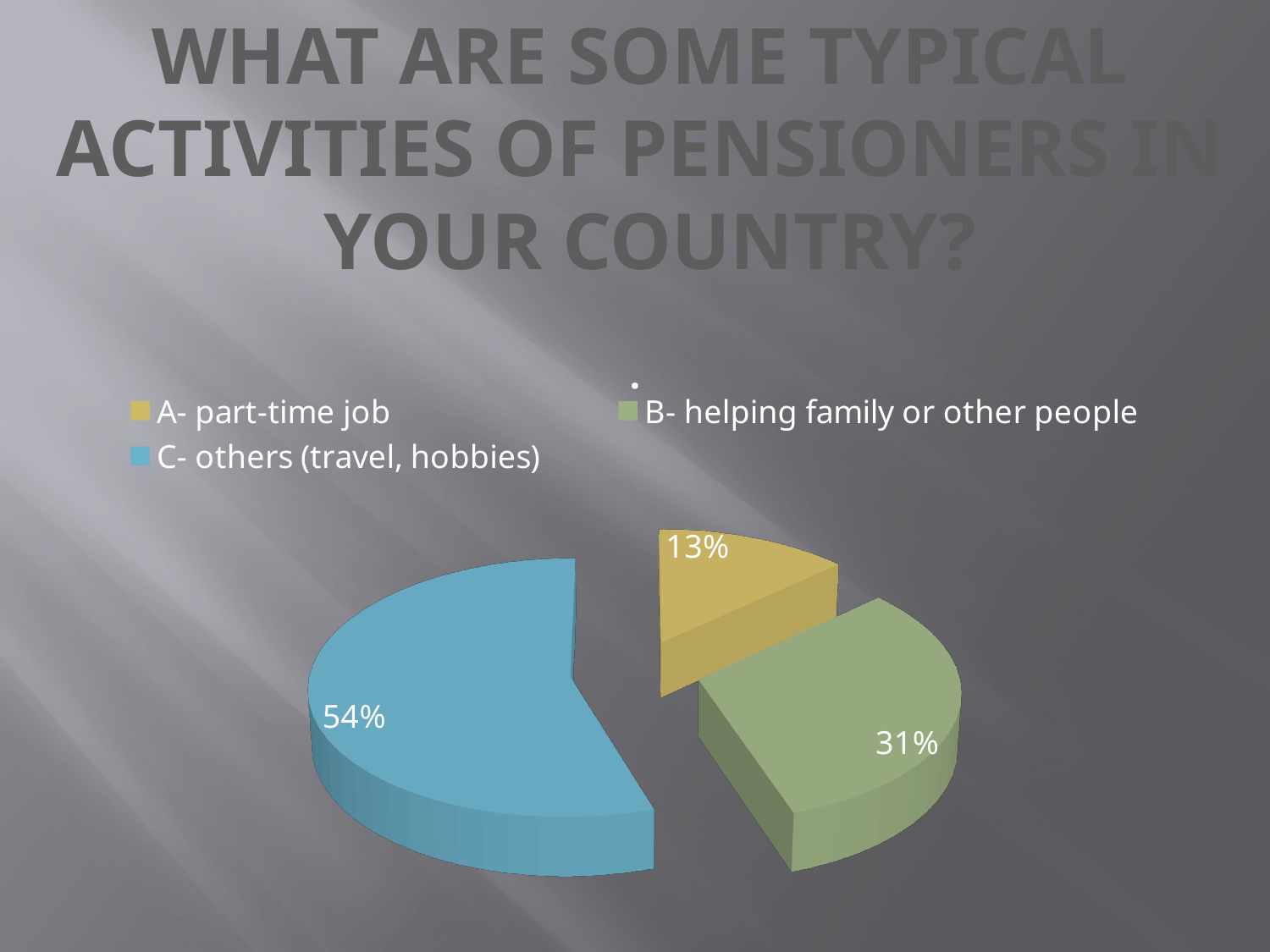
What is the difference in percentage points between 'B- helping family or other people' and 'A- part-time job'? 18 What share of the pie does 'A- part-time job' represent? 13% What is the combined share of 'A- part-time job' and 'B- helping family or other people'? 44% Which category has the smallest slice of the pie? A- part-time job What share of the pie does 'C- others (travel, hobbies)' represent? 54% Which category has the largest slice of the pie? C- others (travel, hobbies) What colour is the slice for 'C- others (travel, hobbies)'? Blue What kind of chart is shown on the slide? Pie chart What is the difference in percentage points between 'C- others (travel, hobbies)' and 'B- helping family or other people'? 23 How many slices does the pie chart have? 3 What share of the pie does 'B- helping family or other people' represent? 31% Which is larger: the slice for 'A- part-time job' or the slice for 'B- helping family or other people'? B- helping family or other people